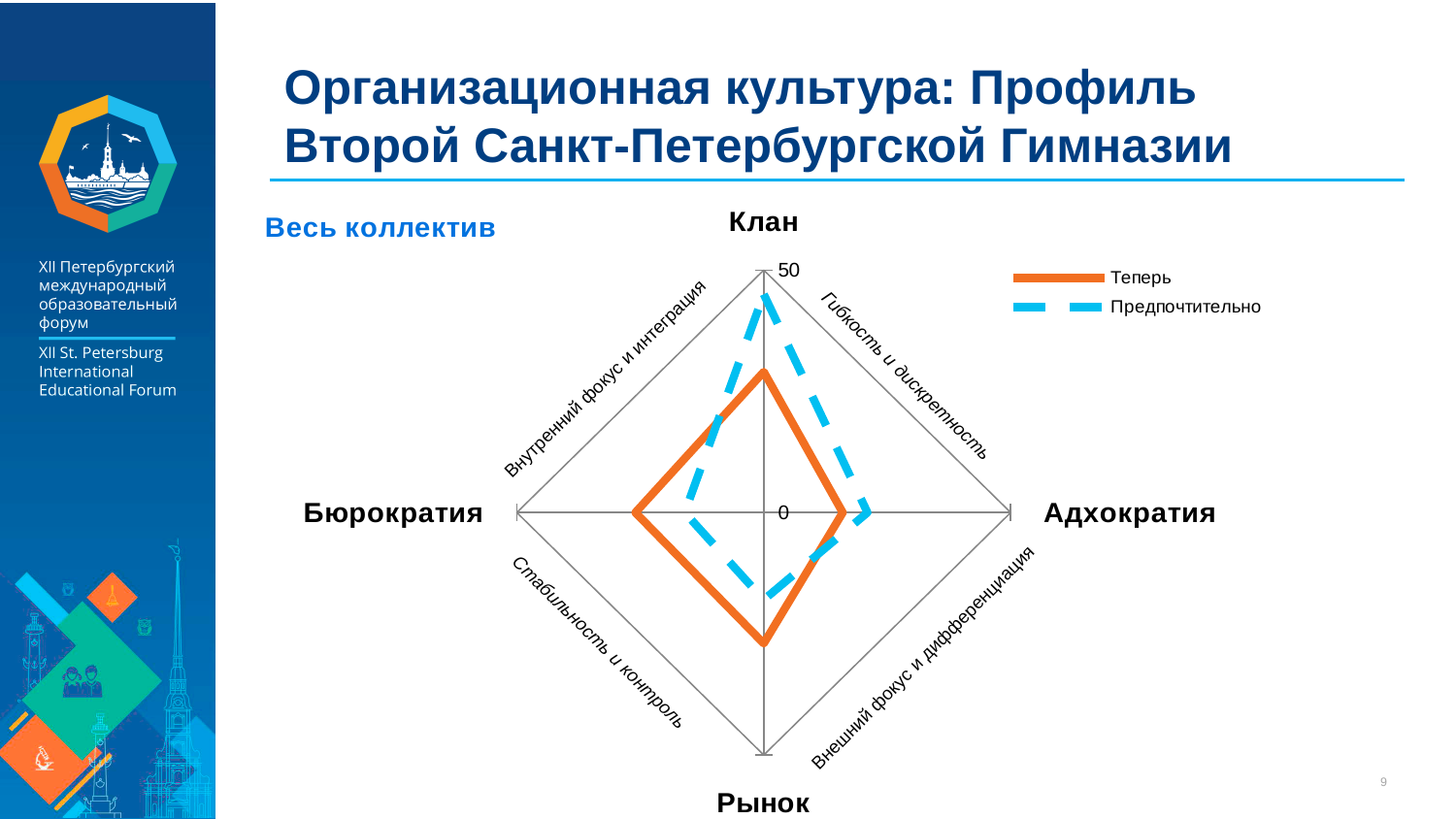
Is the value for Клан in the series Предпочтительно greater or less than 50? less Which series is drawn with a dashed line? Предпочтительно For the category Бюрократия, which series has the larger value, Теперь or Предпочтительно? Теперь How many axes (categories) does the radar chart have? 4 For the category Рынок, which series has the larger value, Теперь or Предпочтительно? Теперь Which category has the lowest value for the series Теперь? Адхократия What colour is the line for the series Теперь? Orange For the category Адхократия, which series has the larger value, Теперь or Предпочтительно? Предпочтительно What kind of chart is shown on the slide? Radar chart How many series does the legend list? 2 Which category has the highest value for the series Предпочтительно? Клан